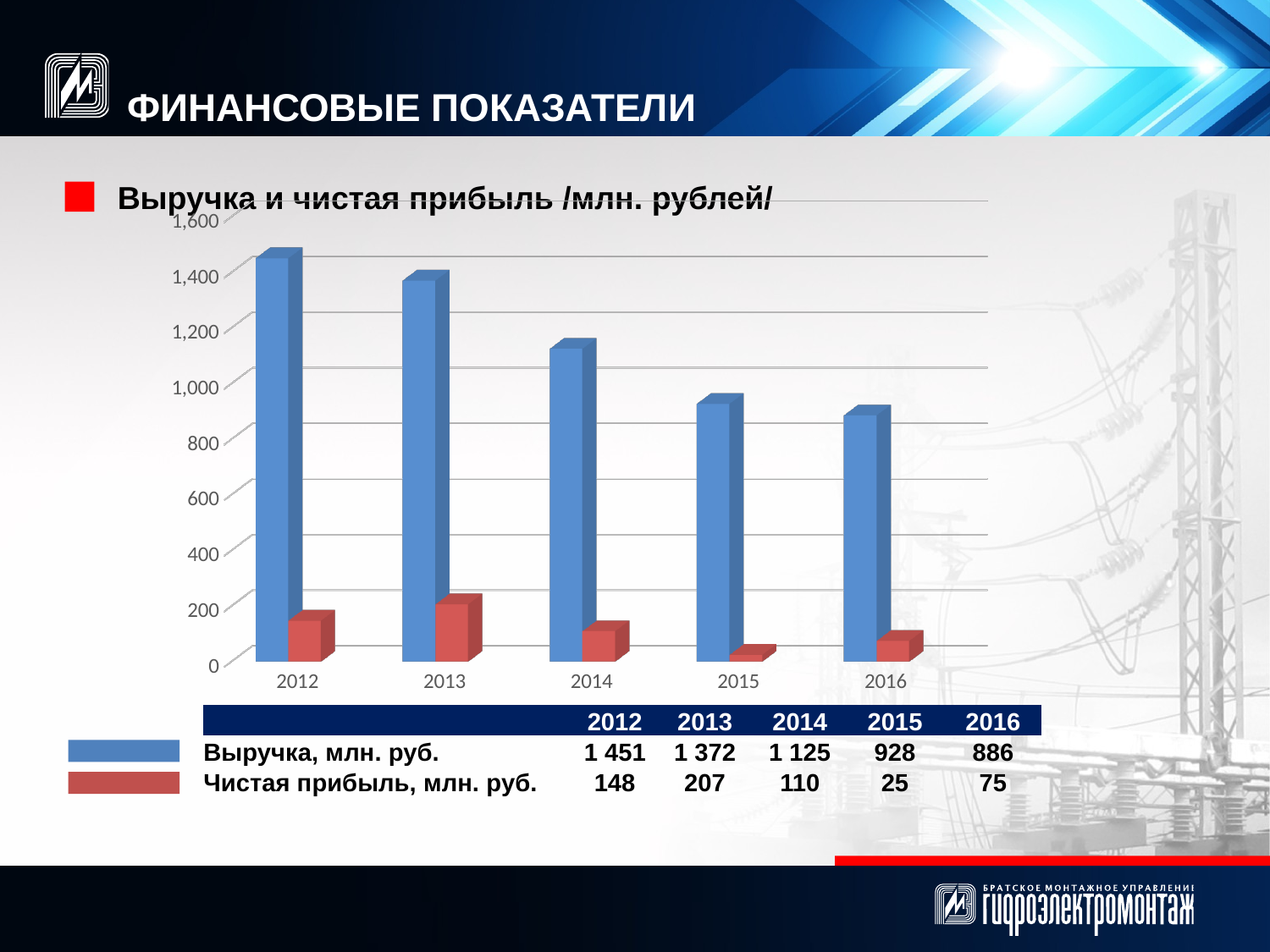
What is the net profit (Чистая прибыль, млн. руб.) for 2015? 25 How many data series does the chart show? 2 Which year has the lowest revenue (Выручка)? 2016 What is the difference between revenue in 2012 and revenue in 2013 (млн. руб.)? 79 What is the revenue (Выручка, млн. руб.) for 2016? 886 Which is larger: net profit in 2014 or net profit in 2016? 2014 Is the revenue for 2015 greater or less than 1,000? less Which year has the highest net profit (Чистая прибыль)? 2013 What is the revenue (Выручка, млн. руб.) for 2012? 1 451 What type of chart is shown on the slide? bar chart How many years are shown on the x axis of the chart? 5 Does revenue (Выручка) rise or fall from 2012 to 2016? fall